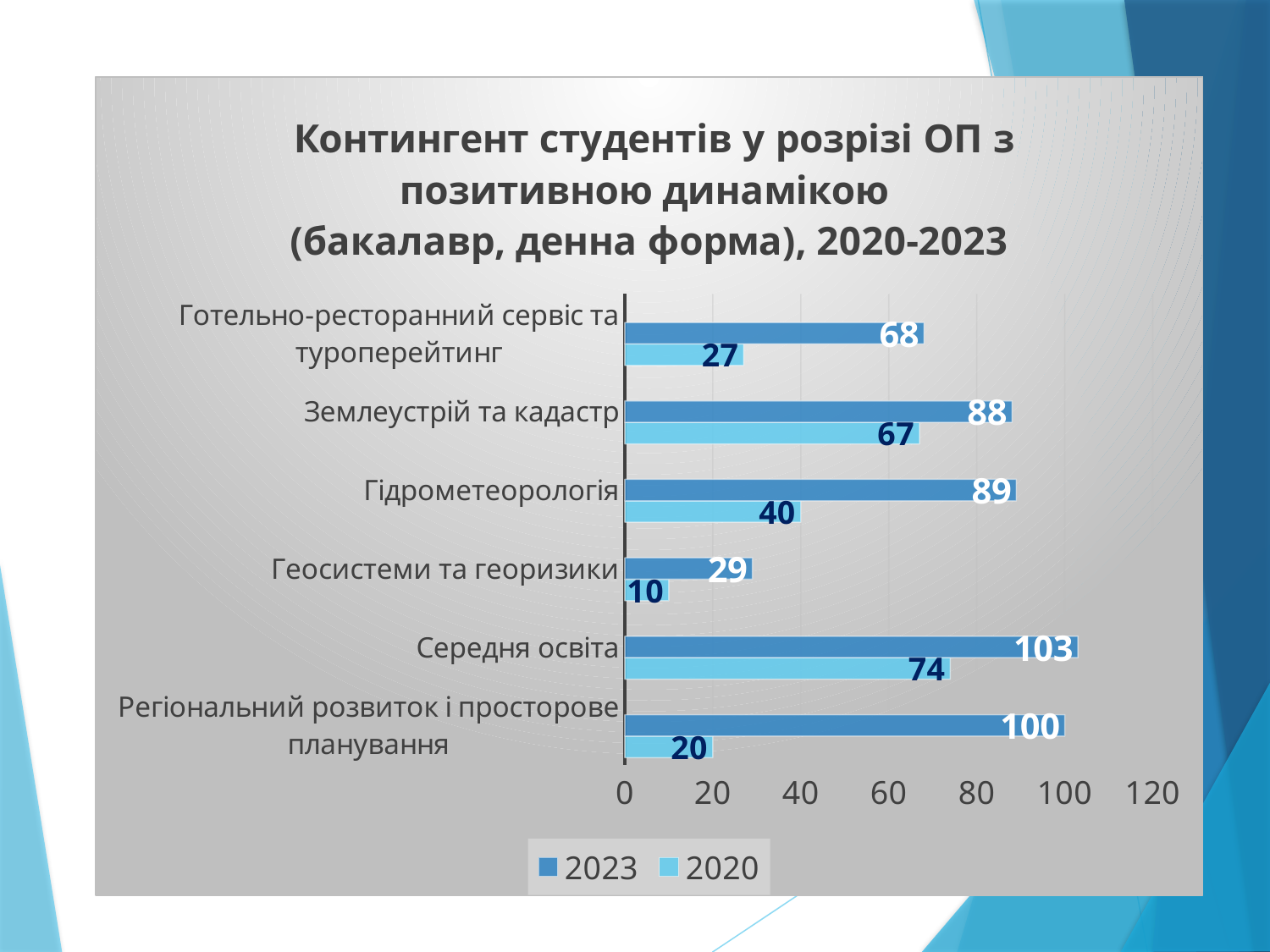
What is the 2023 value for Середня освіта? 103 What is the 2020 value for Гідрометеорологія? 40 Which is larger: the 2023 value for Гідрометеорологія or the 2023 value for Землеустрій та кадастр? Гідрометеорологія What is the difference between the 2023 and 2020 values for Землеустрій та кадастр? 21 Which series is shown in the darker blue colour? 2023 How many categories are shown on the chart? 6 How many series does the legend list? 2 What kind of chart is shown on the slide? Bar chart What is the 2020 value for Регіональний розвиток і просторове планування? 20 Which category has the lowest 2020 value? Геосистеми та георизики Which category has the highest 2023 value? Середня освіта What is the difference between the 2023 and 2020 values for Регіональний розвиток і просторове планування? 80